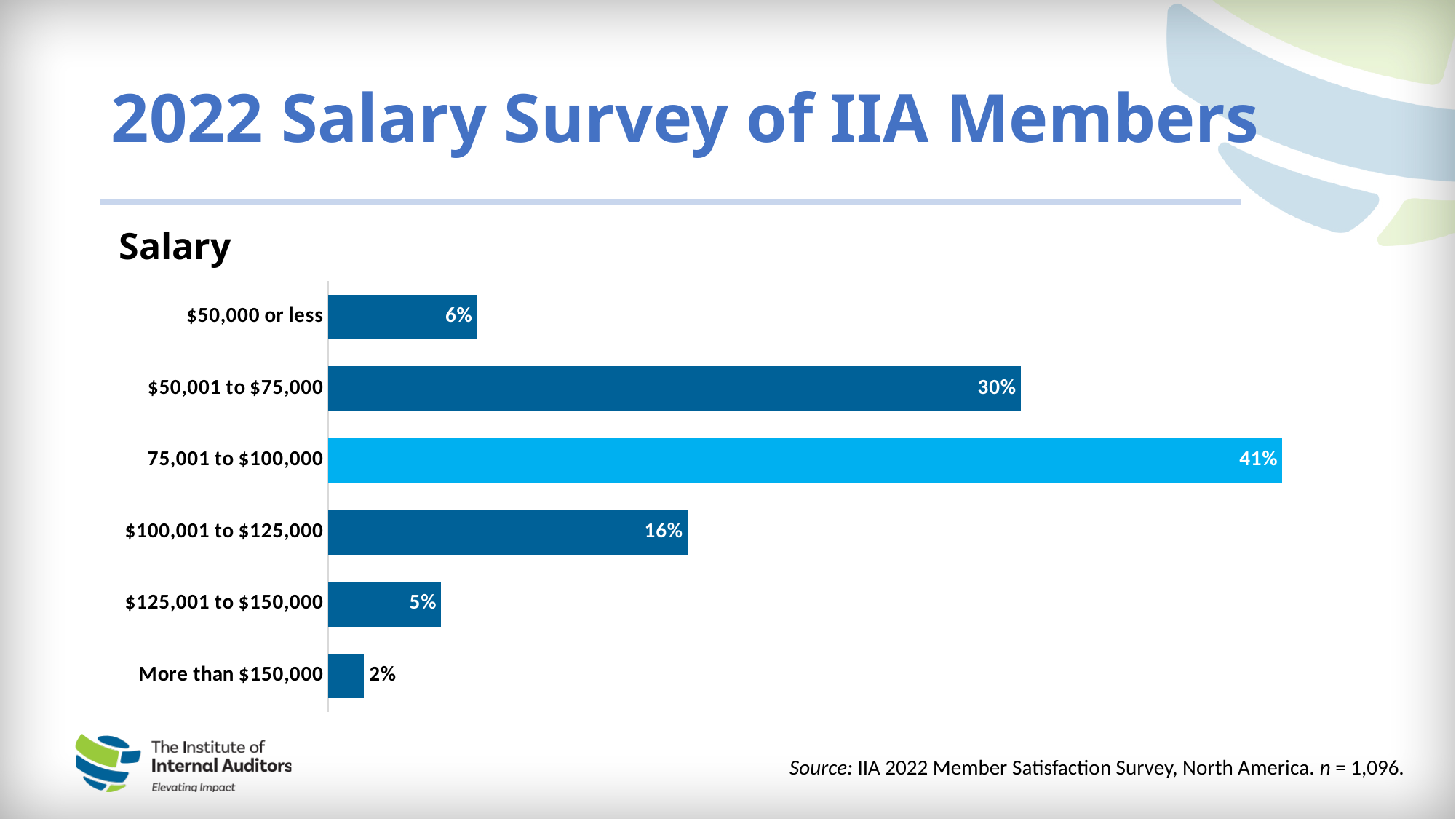
Which bar is shown in a lighter blue colour than the others? $75,001 to $100,000 What percentage of respondents earn more than $150,000? 2% How many salary ranges are shown in the chart? 6 Which salary range has the highest percentage of respondents? $75,001 to $100,000 What percentage of respondents earn $50,000 or less? 6% Which salary range has the lowest percentage of respondents? More than $150,000 What is the difference in percentage points between the $50,001 to $75,000 range and the $100,001 to $125,000 range? 14 What percentage of respondents earn $100,001 to $125,000? 16% What percentage of respondents earn $75,001 to $100,000? 41% What is the title of the chart? Salary What type of chart is used to show the salary distribution? Bar chart Which has a larger share of respondents: $50,000 or less, or $125,001 to $150,000? $50,000 or less